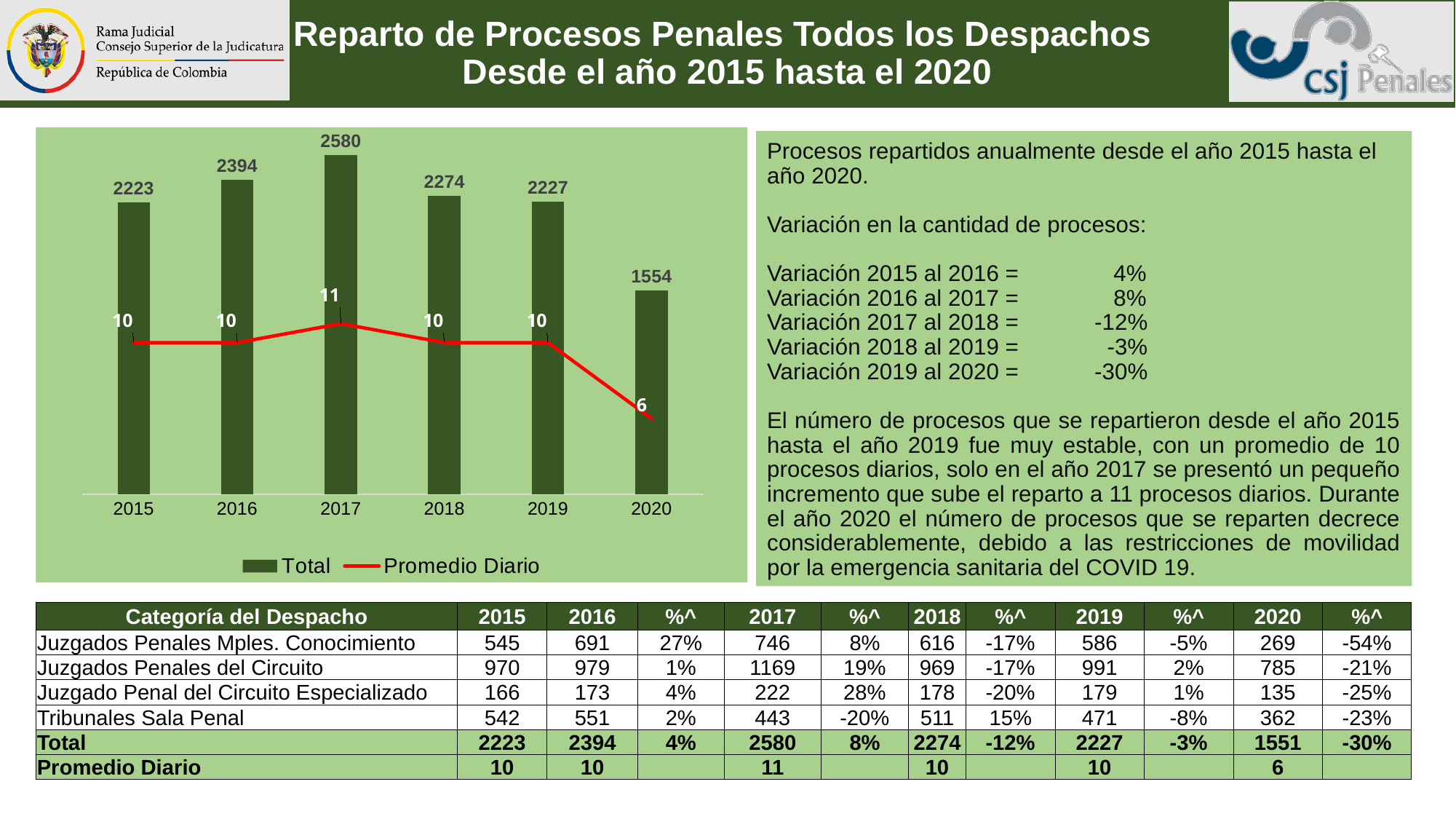
How many series does the chart legend list? 2 Does the Promedio Diario line rise or fall from 2019 to 2020? fall What is the Promedio Diario value for 2017 in the chart? 11 Which year has the highest Total in the chart? 2017 Which is larger in the chart, the Total for 2016 or the Total for 2018? 2016 What kind of chart is used for the Total series? bar chart What is the Promedio Diario value for 2020 in the chart? 6 Which year has the lowest Total in the chart? 2020 How many years are shown on the x axis of the chart? 6 What is the difference between the Total for 2017 and the Total for 2020 in the chart? 1026 What is the Total value for 2017 in the chart? 2580 What is the Total value for 2020 in the chart? 1554